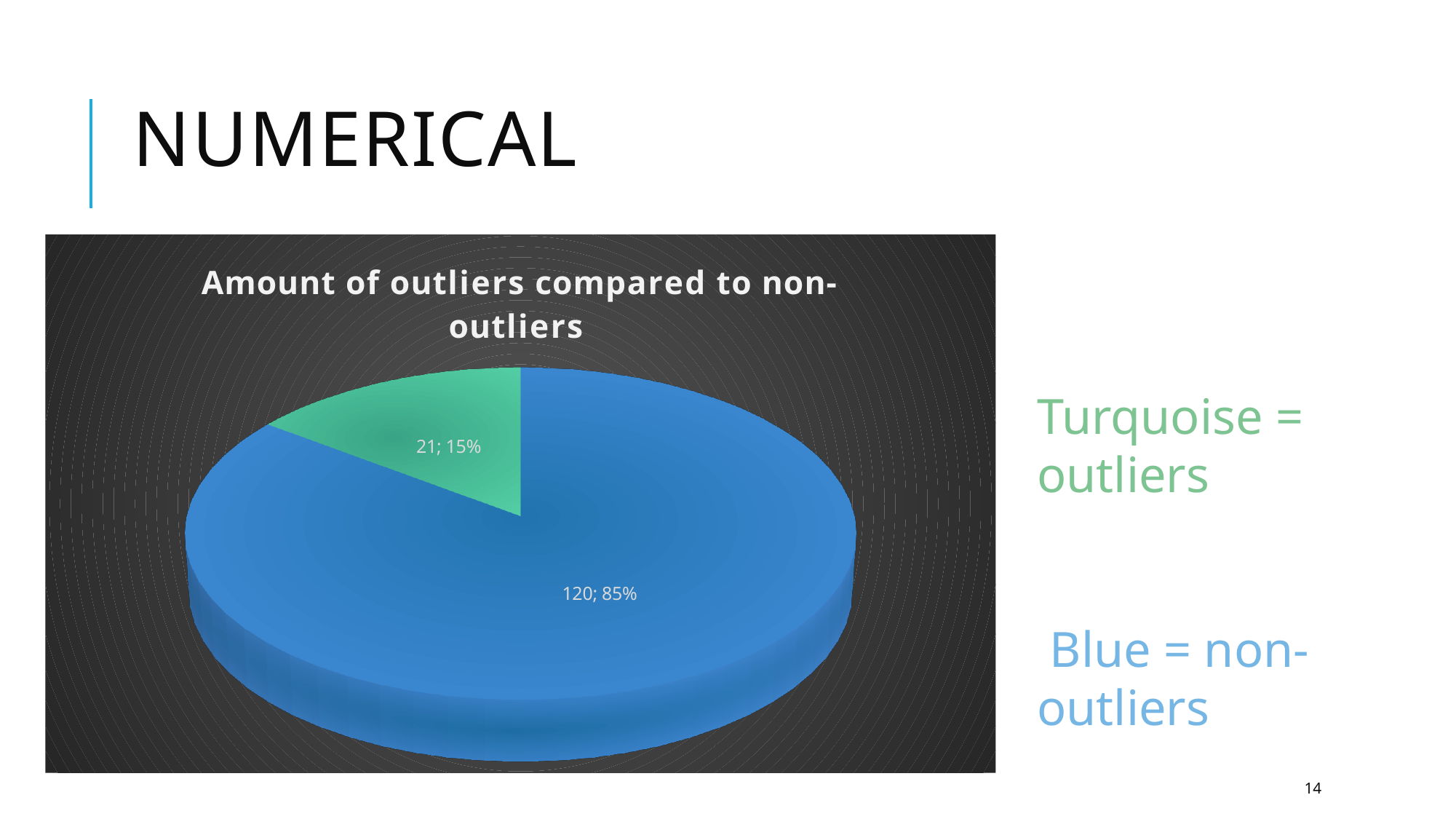
Which slice is larger, outliers or non-outliers? non-outliers What is the count of outliers shown on the pie chart? 21 What share of the pie do non-outliers represent? 85% What is the difference between the number of non-outliers and the number of outliers? 99 What kind of chart is shown on the slide? pie chart What share of the pie do outliers represent? 15% How many slices does the pie chart have? 2 Which category has the smallest slice in the pie chart? outliers What is the total number of data points represented in the pie chart? 141 Which colour represents outliers in the pie chart? Turquoise What is the title of the chart? Amount of outliers compared to non-outliers What is the count of non-outliers shown on the pie chart? 120